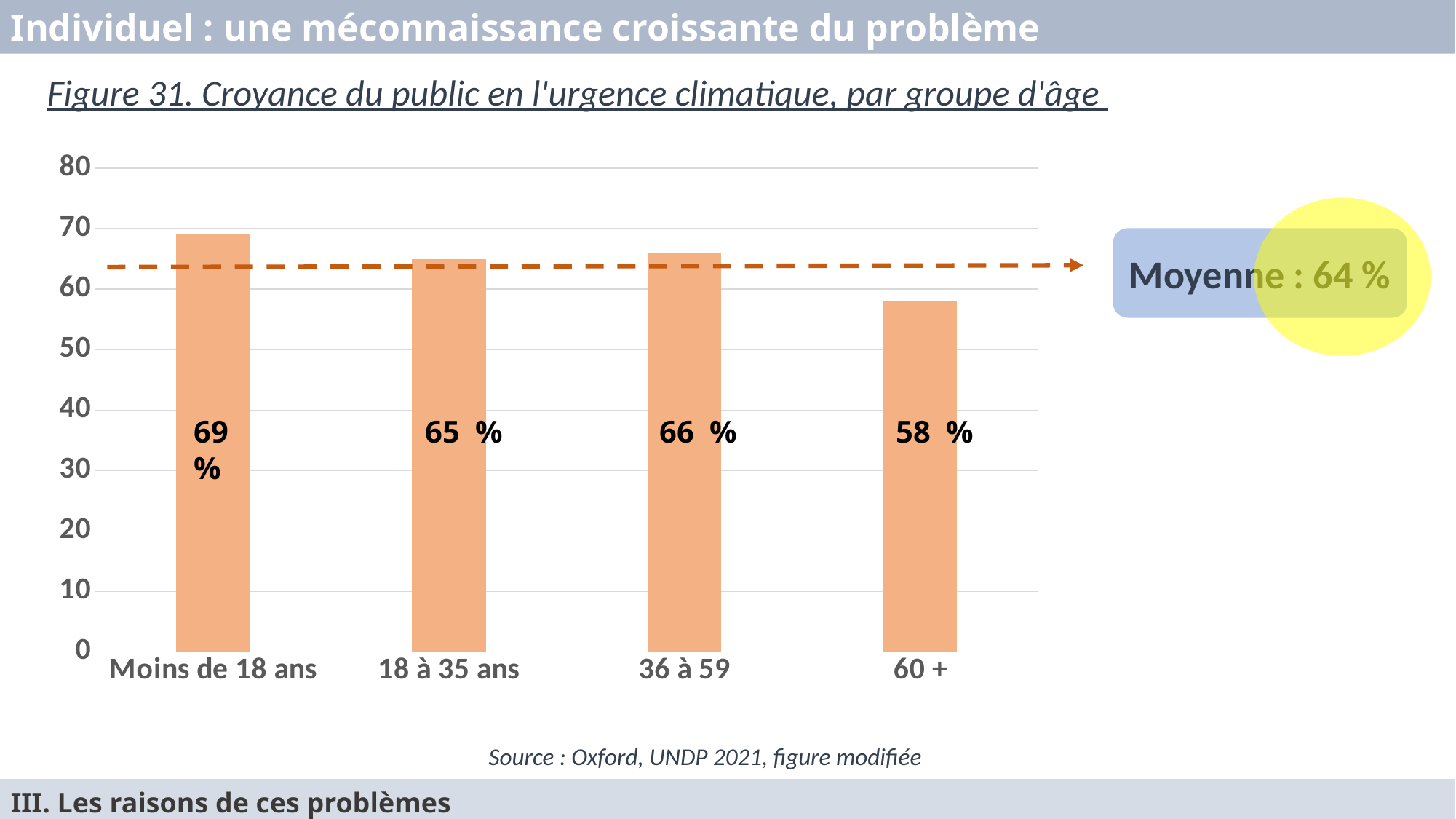
Which is larger, the value for '36 à 59' or the value for '18 à 35 ans'? 36 à 59 What kind of chart is shown on the slide? bar chart Which age group has the lowest value? 60 + What is the value for the '60 +' age group? 58 % What is the value for the '36 à 59' age group? 66 % What is the difference between the values for 'Moins de 18 ans' and '60 +'? 11 % How many age groups are shown in the chart? 4 Is the value for '60 +' greater or less than 60? less What is the value for the '18 à 35 ans' age group? 65 % Which age group has the highest value? Moins de 18 ans What is the value for the 'Moins de 18 ans' age group? 69 % What average value (Moyenne) is indicated by the dashed line on the chart? 64 %